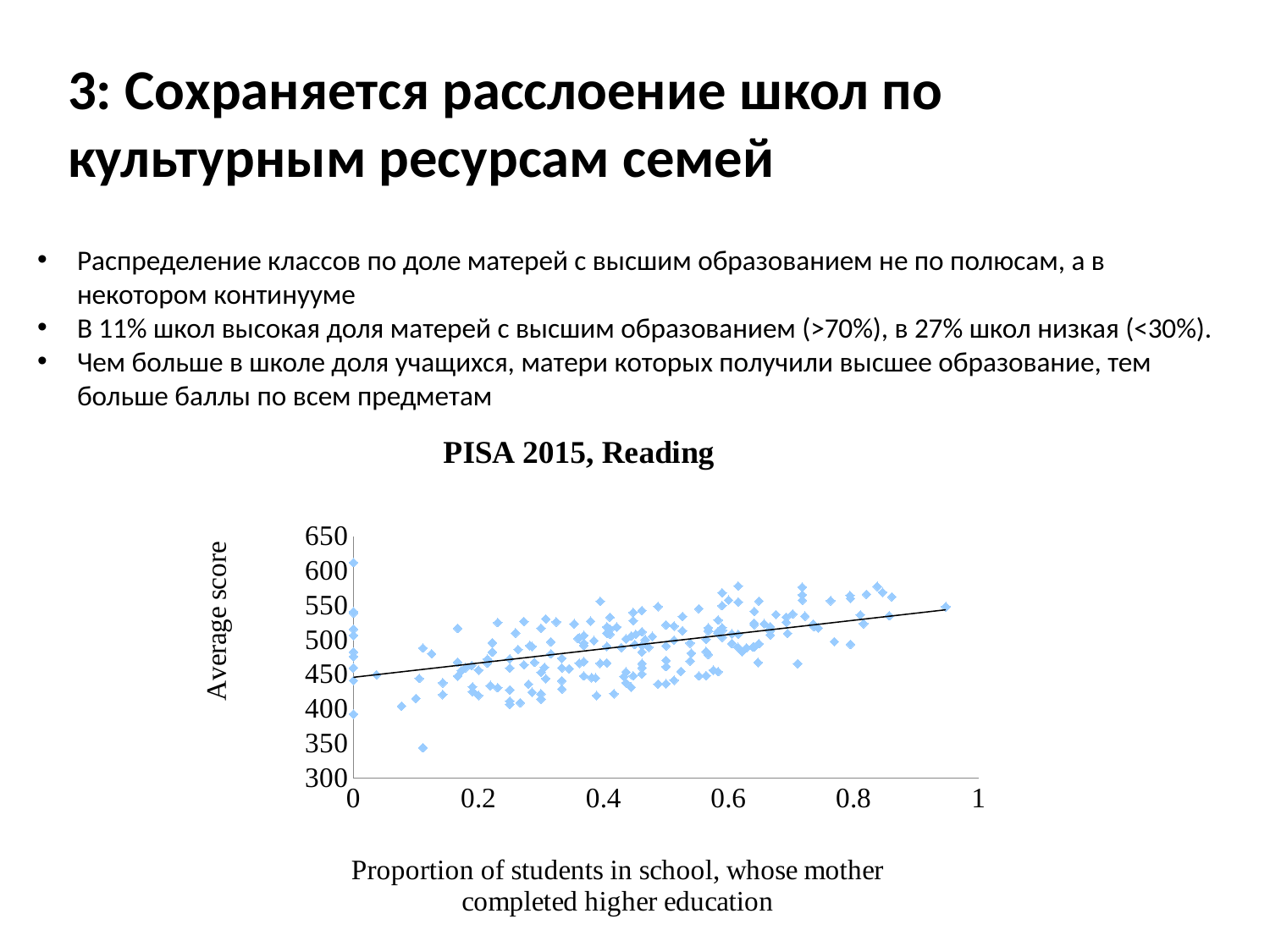
What is the label of the vertical axis of the chart? Average score Is the highest plotted point in the chart greater or less than 550? greater Do the average scores generally rise or fall as the proportion of students whose mother completed higher education increases? Rise Is the lowest plotted point in the chart greater or less than 400? less What is the highest tick value shown on the horizontal axis of the chart? 1 What kind of chart is shown on the slide? Scatter plot What is the lowest value shown on the vertical axis of the chart? 300 What is the highest value shown on the vertical axis of the chart? 650 What is the title of the chart? PISA 2015, Reading Does the fitted trend line in the chart slope upward or downward from left to right? Upward